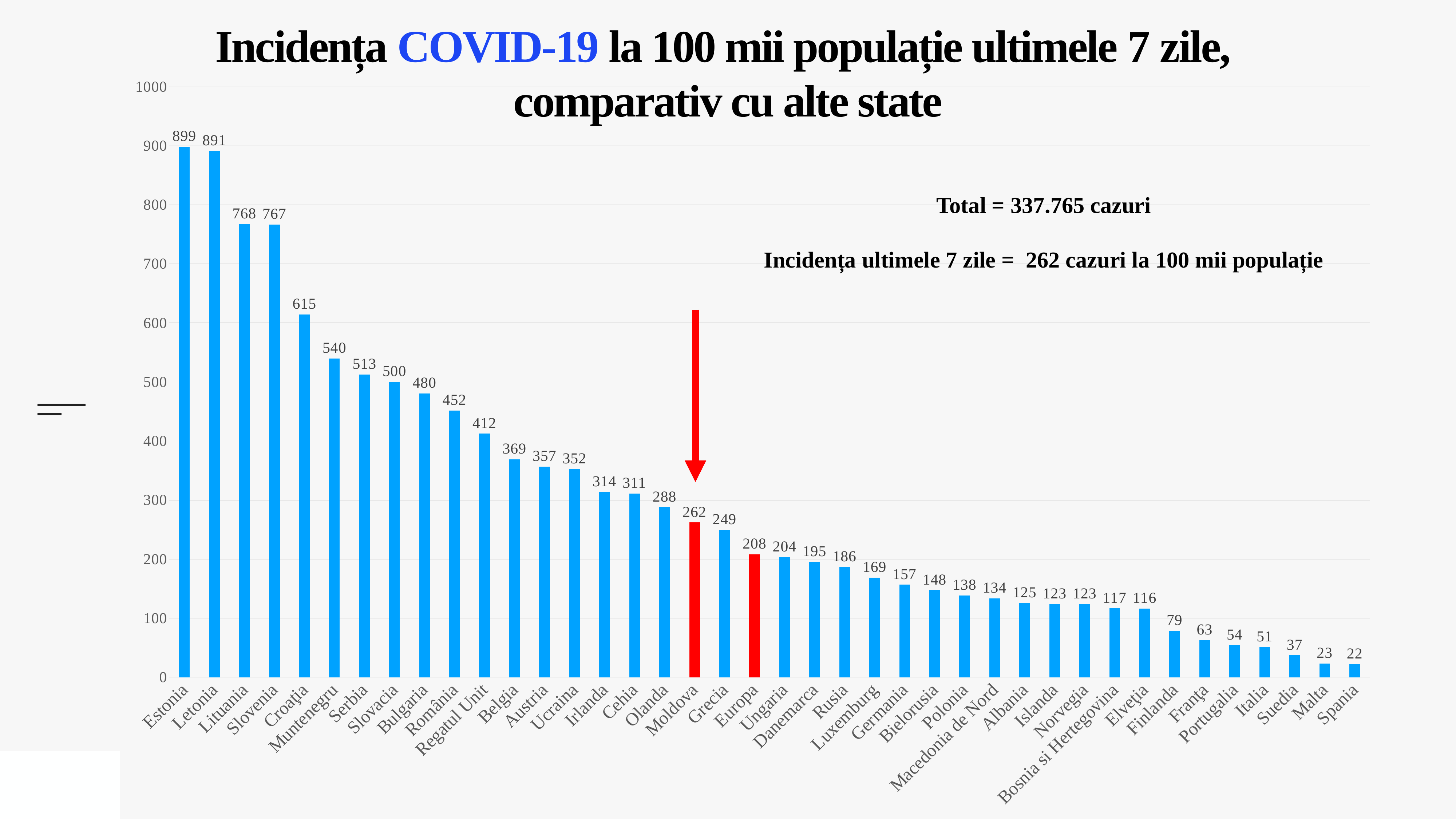
How many countries/categories are shown on the chart? 40 Do the values rise or fall from left to right along the x axis? Fall What is the value for Macedonia de Nord? 134 Which has a larger value, Croația or Muntenegru? Croația Which country has the highest value? Estonia What is the difference between the values for Moldova and Europa? 54 What is the value for Moldova? 262 Which bars are coloured red instead of blue? Moldova and Europa Which country has the lowest value? Spania What is the value for Europa? 208 What is the value for Estonia? 899 What kind of chart is this? Bar chart